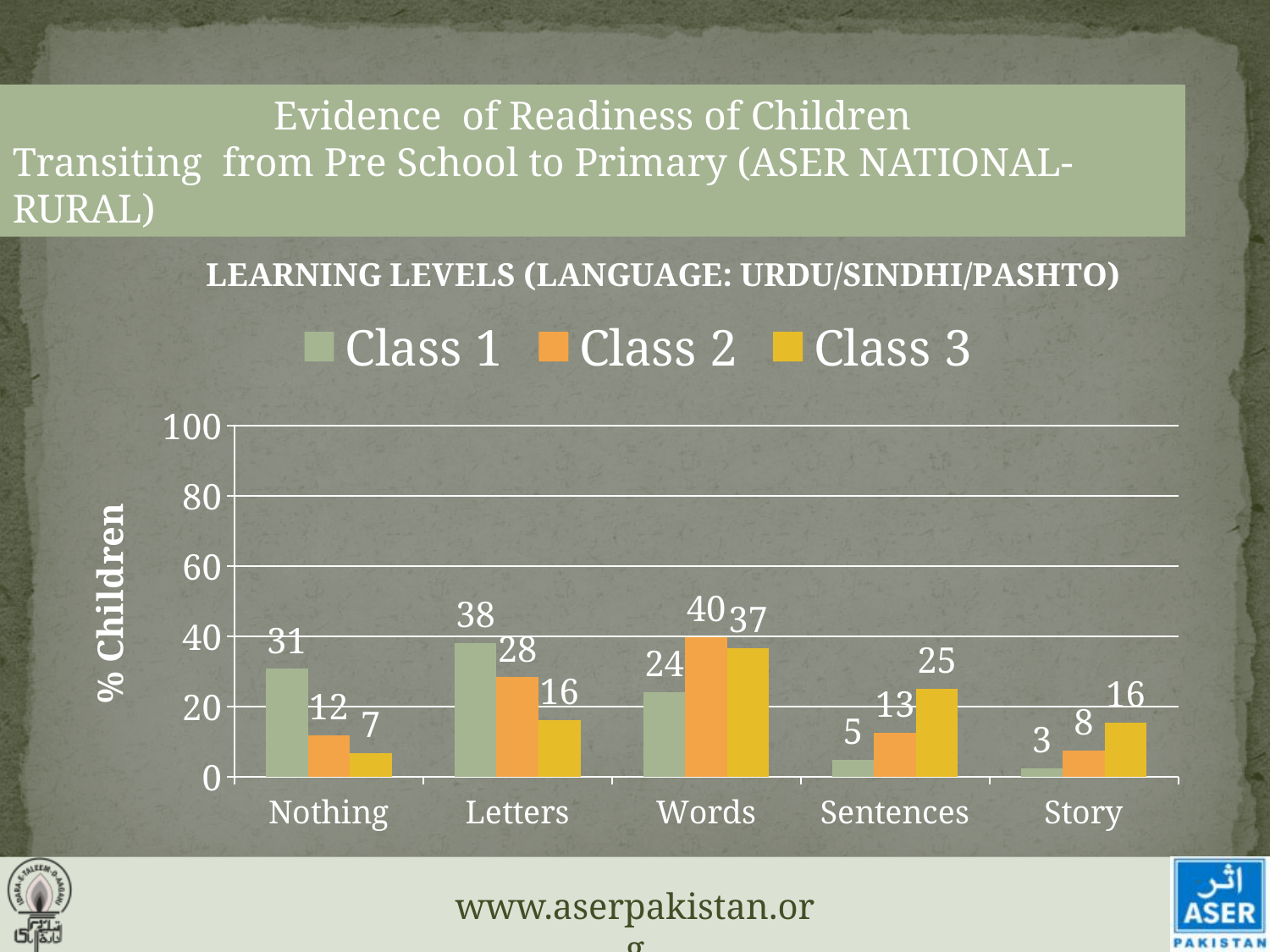
Which category has the lowest value for Class 3? Nothing How many categories are shown on the x axis? 5 How many series does the legend list? 3 What is the difference between the Class 1 and Class 3 values in the Nothing category? 24 What is the value for Class 3 in the Sentences category? 25 Do the Class 1 values rise or fall from Words to Story along the x axis? Fall What is the label of the y axis? % Children Which category has the highest value for Class 1? Letters Which is larger in the Letters category: Class 1 or Class 2? Class 1 What is the value for Class 1 in the Nothing category? 31 What kind of chart is shown on the slide? Bar chart What is the value for Class 2 in the Words category? 40